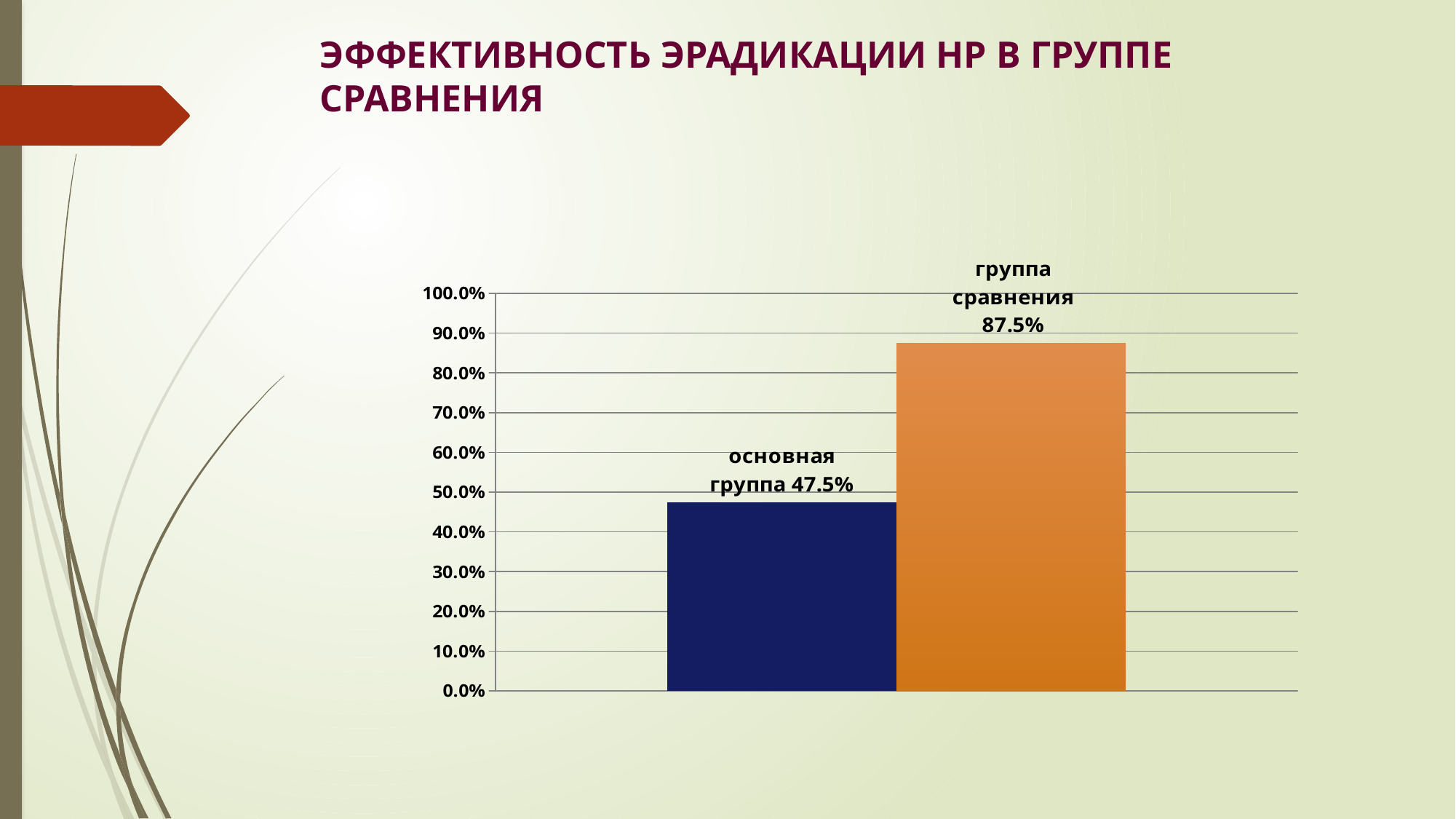
How many bars are shown in the chart? 2 Is the value for группа сравнения greater or less than 80.0%? greater What is the value for основная группа? 47.5% Which is larger, the value for основная группа or the value for группа сравнения? группа сравнения Which group has the highest value? группа сравнения What is the difference between the values for группа сравнения and основная группа? 40.0% What kind of chart is shown on the slide? bar chart What colour is the bar for группа сравнения? orange Which group has the lowest value? основная группа Is the value for основная группа greater or less than 50.0%? less What is the value for группа сравнения? 87.5% What is the title of the slide? ЭФФЕКТИВНОСТЬ ЭРАДИКАЦИИ HP В ГРУППЕ СРАВНЕНИЯ